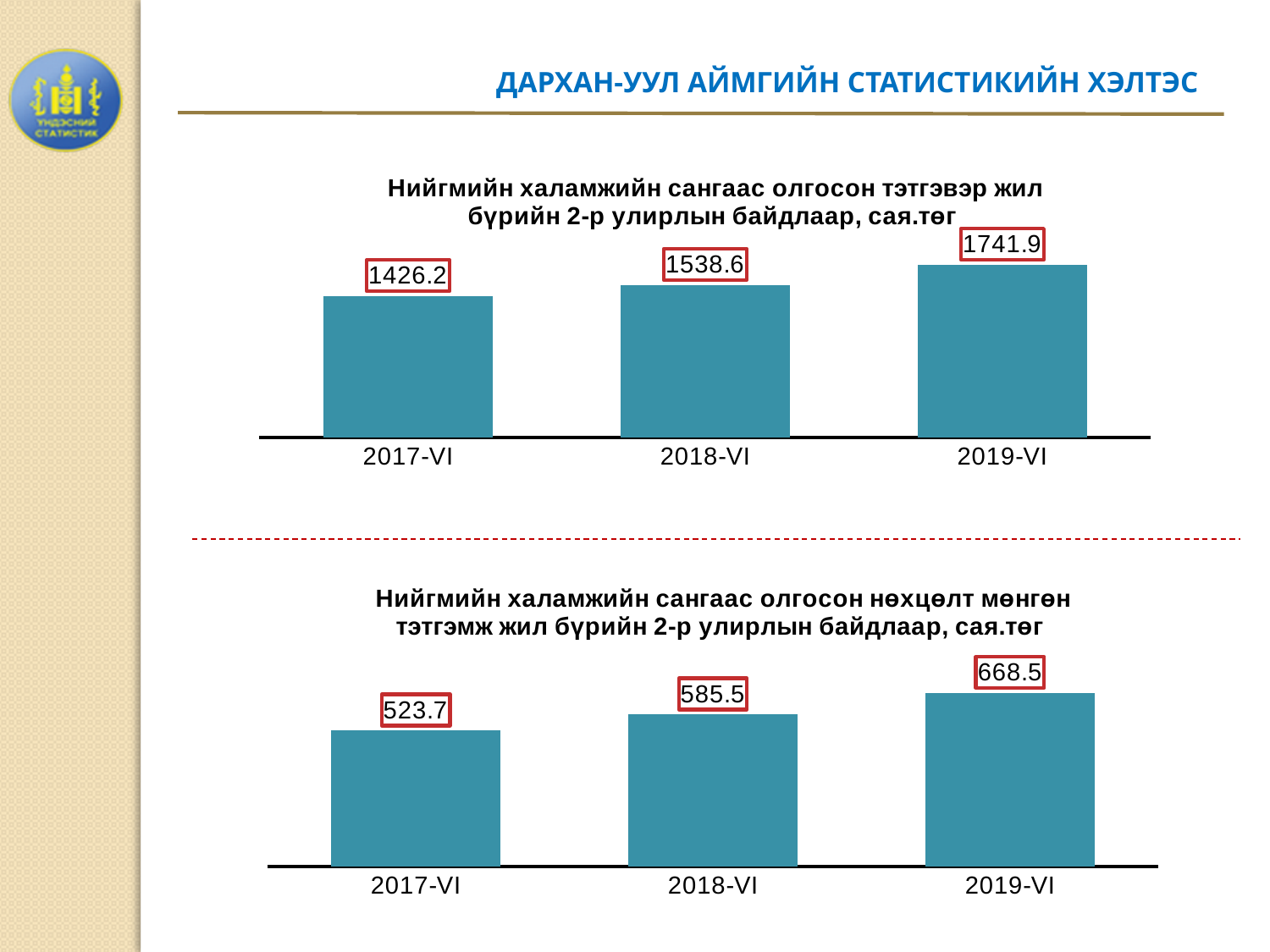
In the top chart (pensions from the social welfare fund), what is the value for 2019-VI? 1741.9 How many periods are shown on the x axis of the top chart (pensions from the social welfare fund)? 3 In the top chart (pensions from the social welfare fund), what is the value for 2017-VI? 1426.2 In the bottom chart (conditional cash allowances), what is the value for 2019-VI? 668.5 In the bottom chart (conditional cash allowances), what is the value for 2018-VI? 585.5 In the bottom chart (conditional cash allowances), which period has the lowest value? 2017-VI In the top chart (pensions from the social welfare fund), do the values rise or fall from 2017-VI to 2019-VI? rise What type of chart is the bottom chart (conditional cash allowances)? bar chart In the bottom chart (conditional cash allowances), which is larger, the value for 2018-VI or 2017-VI? 2018-VI In the top chart (pensions from the social welfare fund), which period has the highest value? 2019-VI In the bottom chart (conditional cash allowances), what is the difference between the 2019-VI and 2017-VI values? 144.8 In the top chart (pensions from the social welfare fund), what is the difference between the 2019-VI and 2017-VI values? 315.7